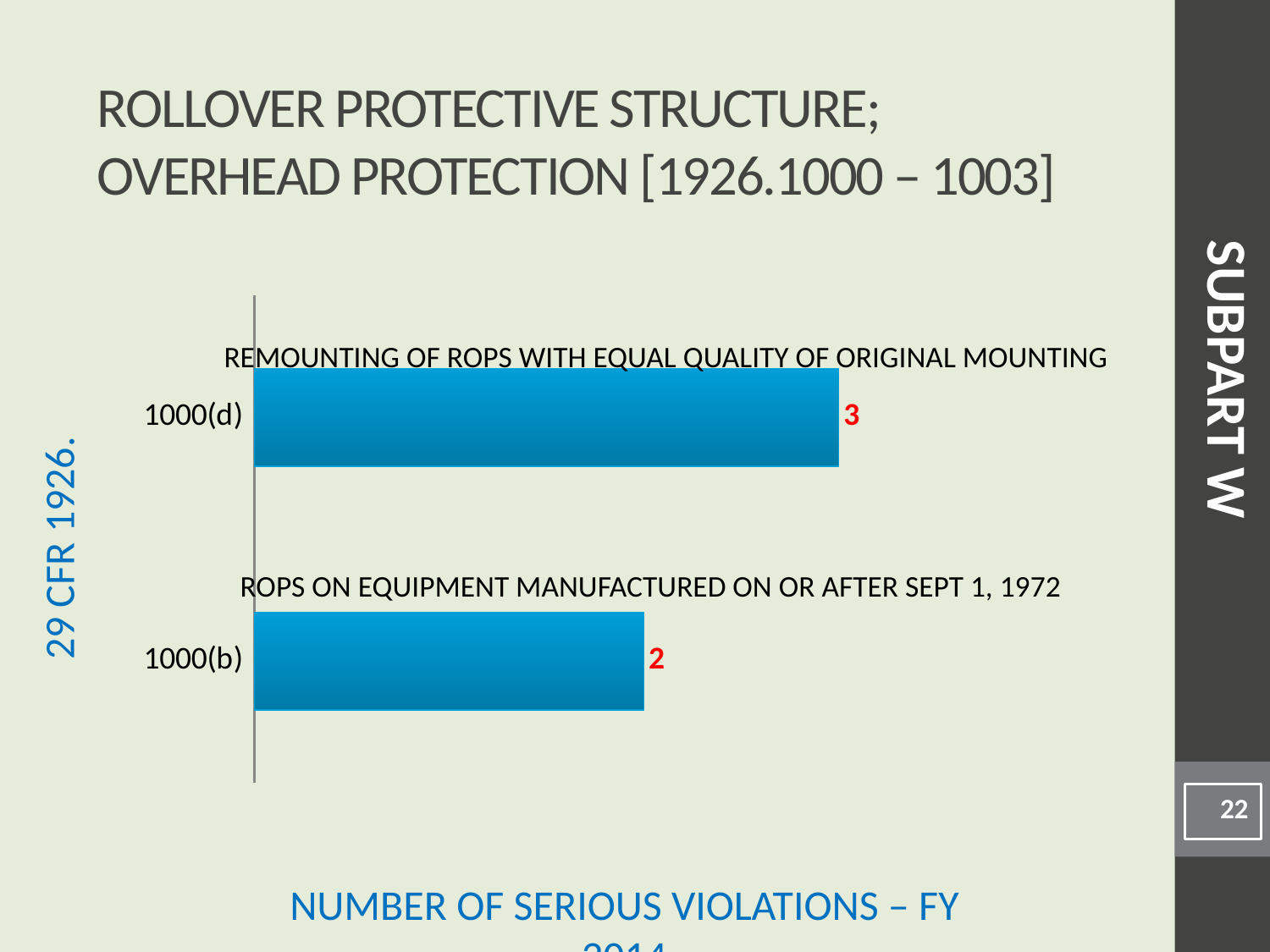
What is the total number of serious violations across both categories? 5 What kind of chart is shown on the slide? Bar chart What is the number of serious violations for 1000(b)? 2 What is the difference between the values for 1000(d) and 1000(b)? 1 What is the number of serious violations for 1000(d)? 3 Which category has the highest number of serious violations? 1000(d) How many categories are shown in the chart? 2 Which category has the lowest number of serious violations? 1000(b) What description is given for the 1000(d) bar? REMOUNTING OF ROPS WITH EQUAL QUALITY OF ORIGINAL MOUNTING What description is given for the 1000(b) bar? ROPS ON EQUIPMENT MANUFACTURED ON OR AFTER SEPT 1, 1972 Which has more serious violations, 1000(d) or 1000(b)? 1000(d)